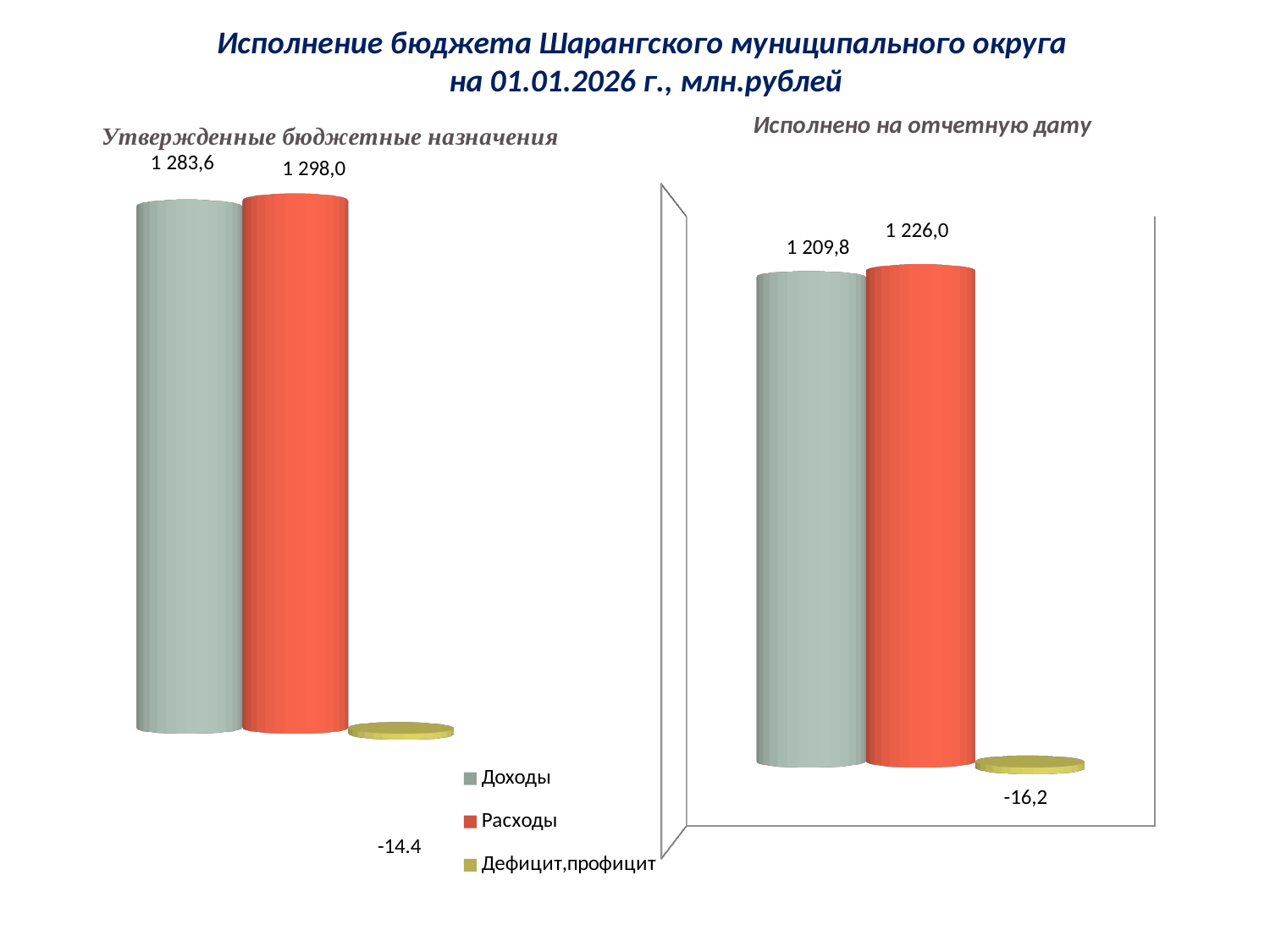
In the chart 'Исполнено на отчетную дату', what is the value for Расходы? 1 226,0 How many series does the legend list? 3 In the chart 'Исполнено на отчетную дату', what is the difference between Расходы and Доходы? 16,2 In the chart 'Исполнено на отчетную дату', what is the value for Дефицит,профицит? -16,2 In the chart 'Утвержденные бюджетные назначения', what is the value for Доходы? 1 283,6 Which is larger: Доходы in 'Утвержденные бюджетные назначения' or Доходы in 'Исполнено на отчетную дату'? Утвержденные бюджетные назначения In the chart 'Исполнено на отчетную дату', what is the value for Доходы? 1 209,8 In the chart 'Утвержденные бюджетные назначения', which series has the lowest value? Дефицит,профицит In the chart 'Утвержденные бюджетные назначения', what is the value for Дефицит,профицит? -14.4 In the chart 'Исполнено на отчетную дату', which series has the highest value? Расходы In the chart 'Утвержденные бюджетные назначения', what is the value for Расходы? 1 298,0 What type of chart is 'Исполнено на отчетную дату'? Bar chart